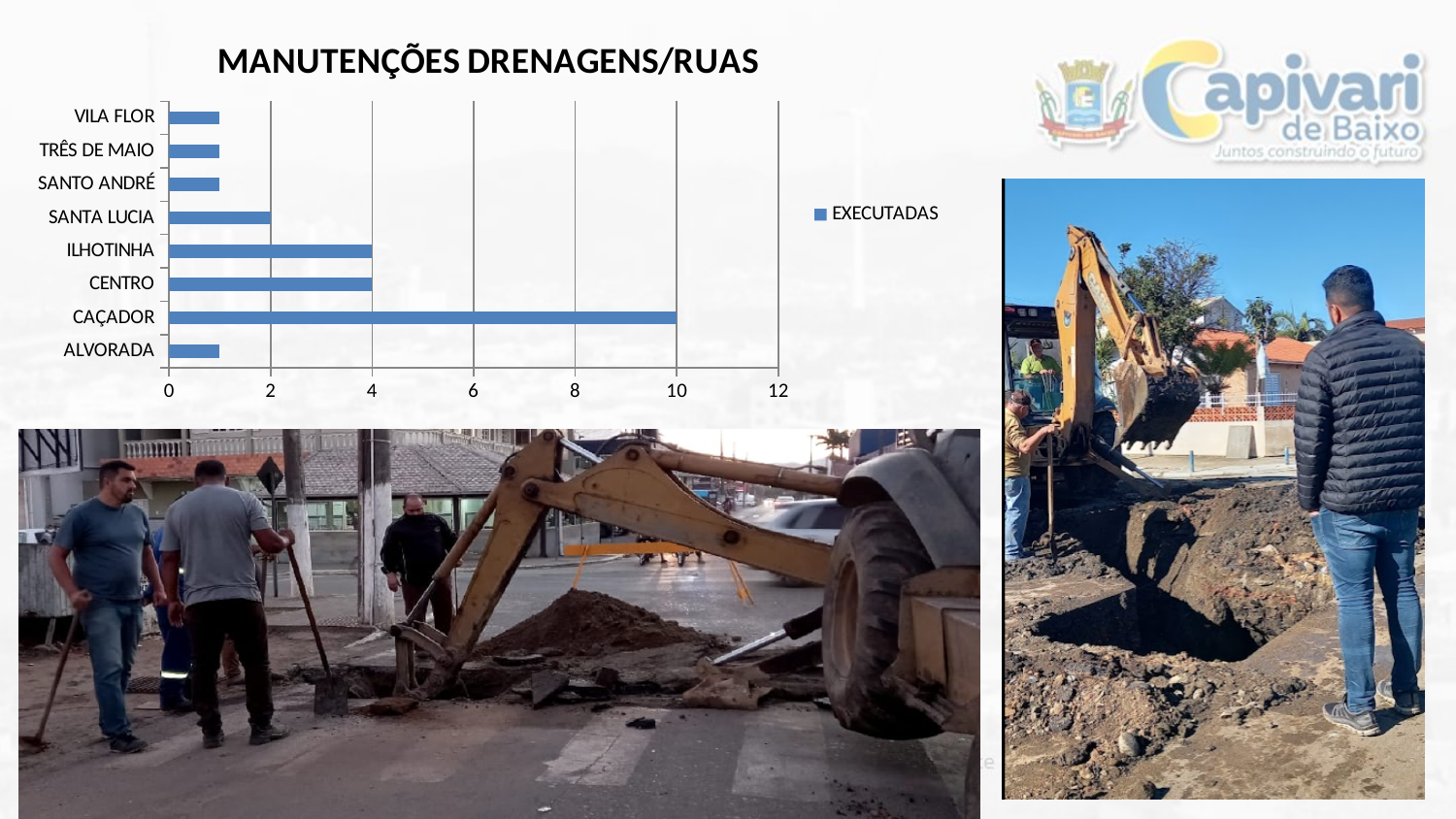
How many series does the chart legend list? 1 What is the difference between the values for CAÇADOR and SANTA LUCIA? 8 Is the value for VILA FLOR greater or less than 2? less What is the title of the chart on the slide? MANUTENÇÕES DRENAGENS/RUAS What is the value for CAÇADOR? 10 What is the value for SANTA LUCIA? 2 What is the name of the series shown in the chart legend? EXECUTADAS Which category has the highest value in the chart? CAÇADOR Which is larger, the value for CAÇADOR or the value for CENTRO? CAÇADOR What is the value for ILHOTINHA? 4 How many categories (neighbourhoods) are shown in the chart? 8 What kind of chart is shown on the slide? bar chart